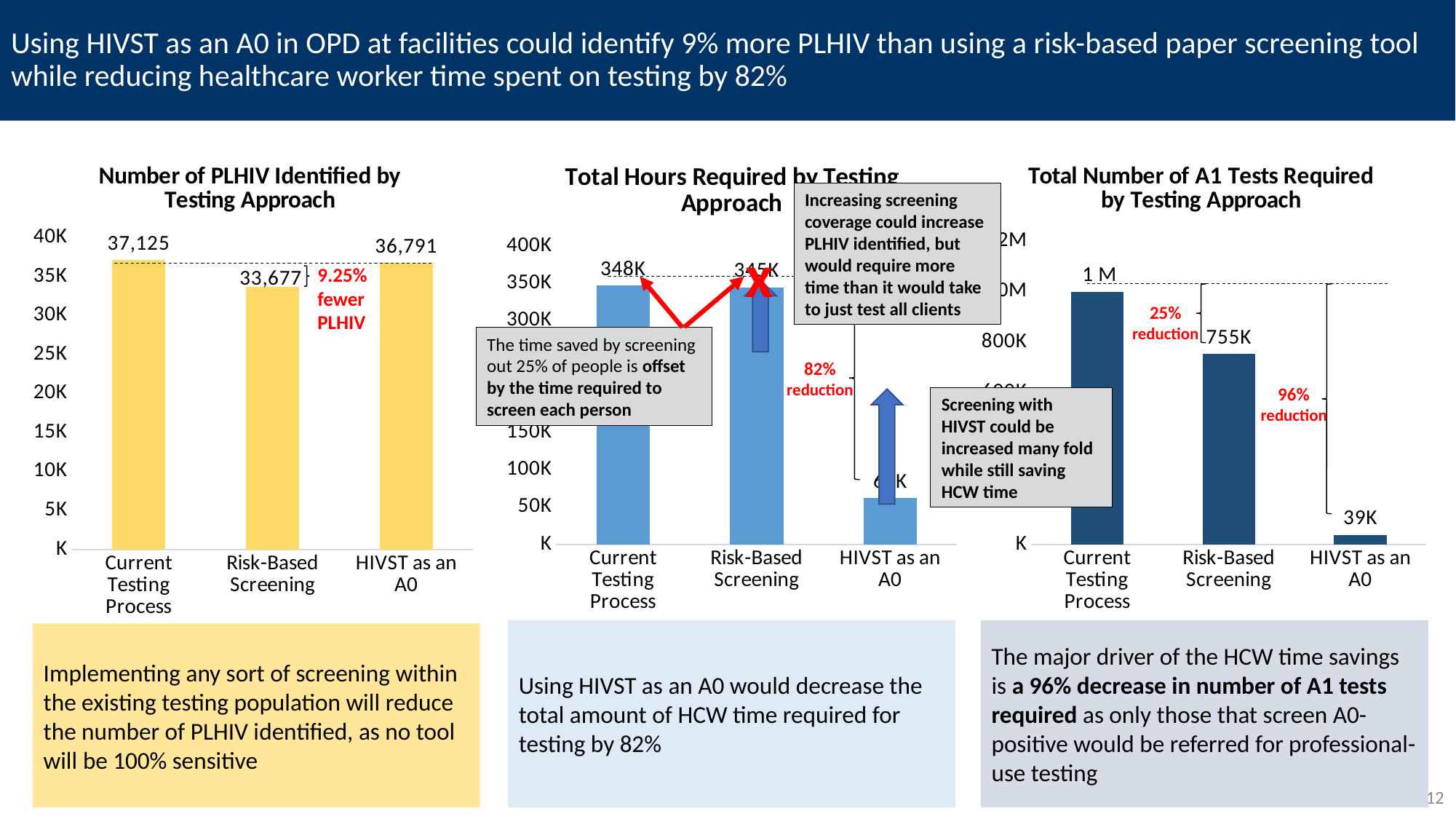
In the 'Number of PLHIV Identified by Testing Approach' chart, what is the value for Risk-Based Screening? 33,677 In the 'Number of PLHIV Identified by Testing Approach' chart, what is the value for Current Testing Process? 37,125 In the 'Total Number of A1 Tests Required by Testing Approach' chart, what is the value for HIVST as an A0? 39K In the 'Number of PLHIV Identified by Testing Approach' chart, what is the value for HIVST as an A0? 36,791 In the 'Total Number of A1 Tests Required by Testing Approach' chart, which is larger, Current Testing Process or Risk-Based Screening? Current Testing Process How many testing approaches are shown on the x axis of the 'Total Number of A1 Tests Required by Testing Approach' chart? 3 In the 'Total Hours Required by Testing Approach' chart, is the value for HIVST as an A0 greater or less than 100K? less In the 'Total Number of A1 Tests Required by Testing Approach' chart, what is the value for Risk-Based Screening? 755K In the 'Number of PLHIV Identified by Testing Approach' chart, what is the difference between Current Testing Process and HIVST as an A0? 334 In the 'Number of PLHIV Identified by Testing Approach' chart, which testing approach has the lowest value? Risk-Based Screening In the 'Total Hours Required by Testing Approach' chart, what is the value for Current Testing Process? 348K In the 'Total Hours Required by Testing Approach' chart, which testing approach has the lowest value? HIVST as an A0